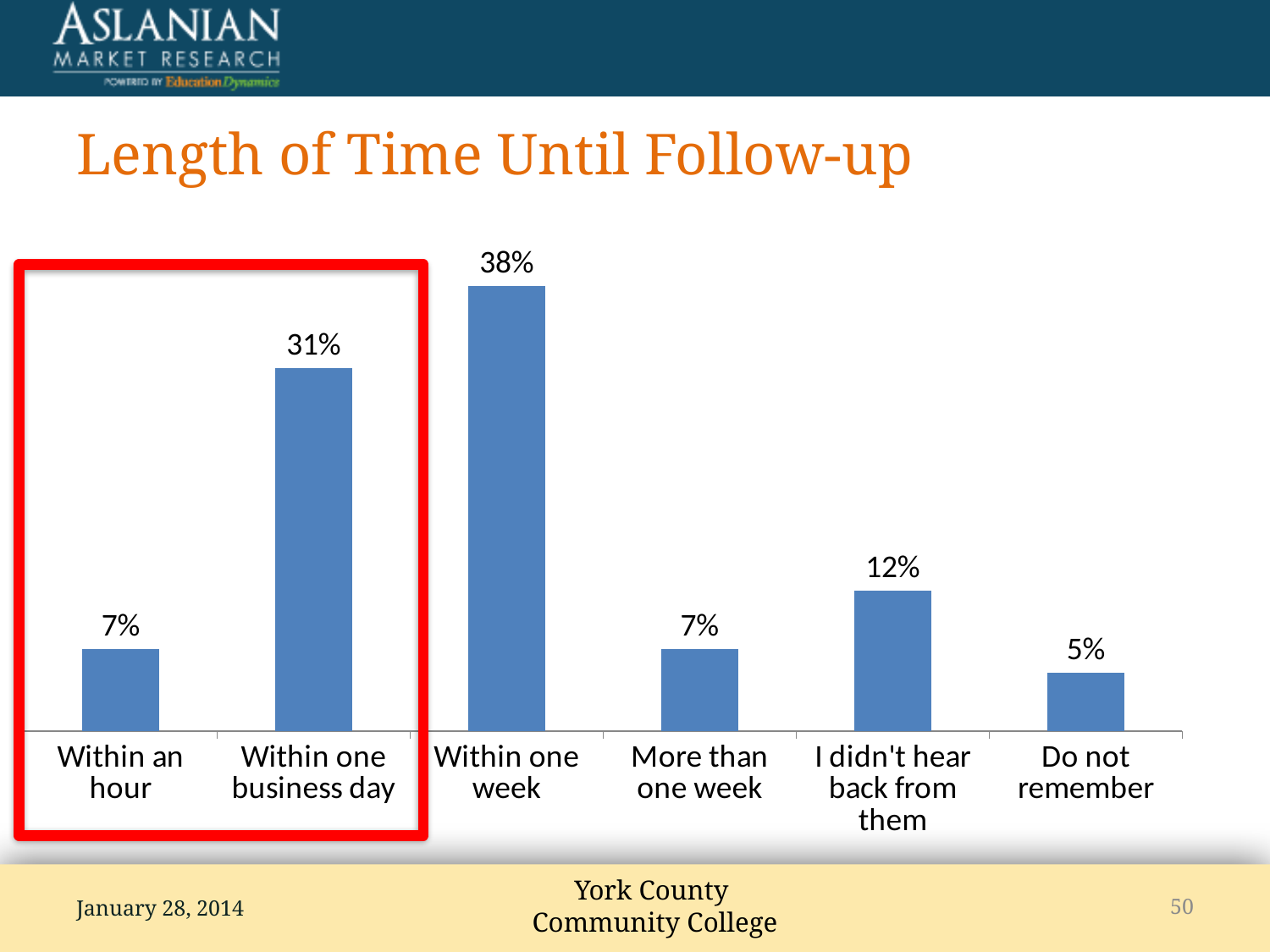
Which category has the lowest value? Do not remember Which category has the highest value? Within one week What is the value for "Within one business day"? 31% Which is larger, the value for "Within an hour" or the value for "I didn't hear back from them"? I didn't hear back from them What is the title of the slide containing the chart? Length of Time Until Follow-up What is the difference between the values for "Within one week" and "Within one business day"? 7% What is the value for "Within one week"? 38% What is the difference between the values for "I didn't hear back from them" and "Do not remember"? 7% How many categories are shown on the x axis? 6 What is the value for "I didn't hear back from them"? 12% What is the value for "Do not remember"? 5% What kind of chart is shown on the slide? Bar chart